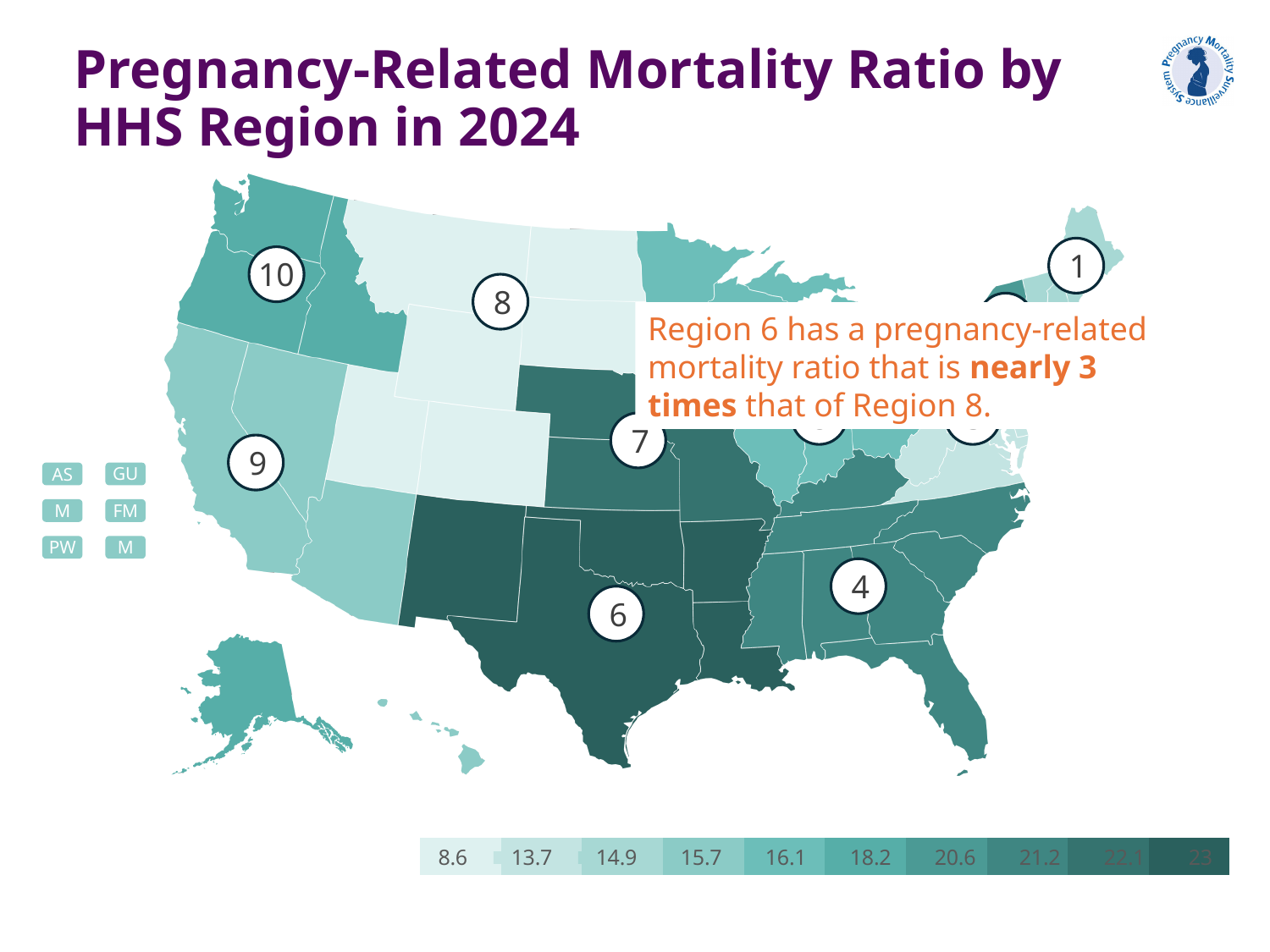
What is the difference between the highest and lowest values on the legend scale? 14.4 What is the title of the chart? Pregnancy-Related Mortality Ratio by HHS Region in 2024 How many values are listed on the colour legend scale? 10 Which region has the higher pregnancy-related mortality ratio, Region 6 or Region 8? Region 6 Which HHS region is shaded darkest, indicating the highest pregnancy-related mortality ratio? Region 6 What is the lowest value shown on the colour legend scale? 8.6 What kind of chart is shown on the slide? A map (choropleth map) Which region is shaded darker, Region 7 or Region 9? Region 7 What is the highest value shown on the colour legend scale? 23 According to the callout on the slide, Region 6's mortality ratio is nearly how many times that of Region 8? Nearly 3 times Which HHS region is shaded lightest, indicating the lowest pregnancy-related mortality ratio? Region 8 Which region is shaded darker, Region 4 or Region 1? Region 4